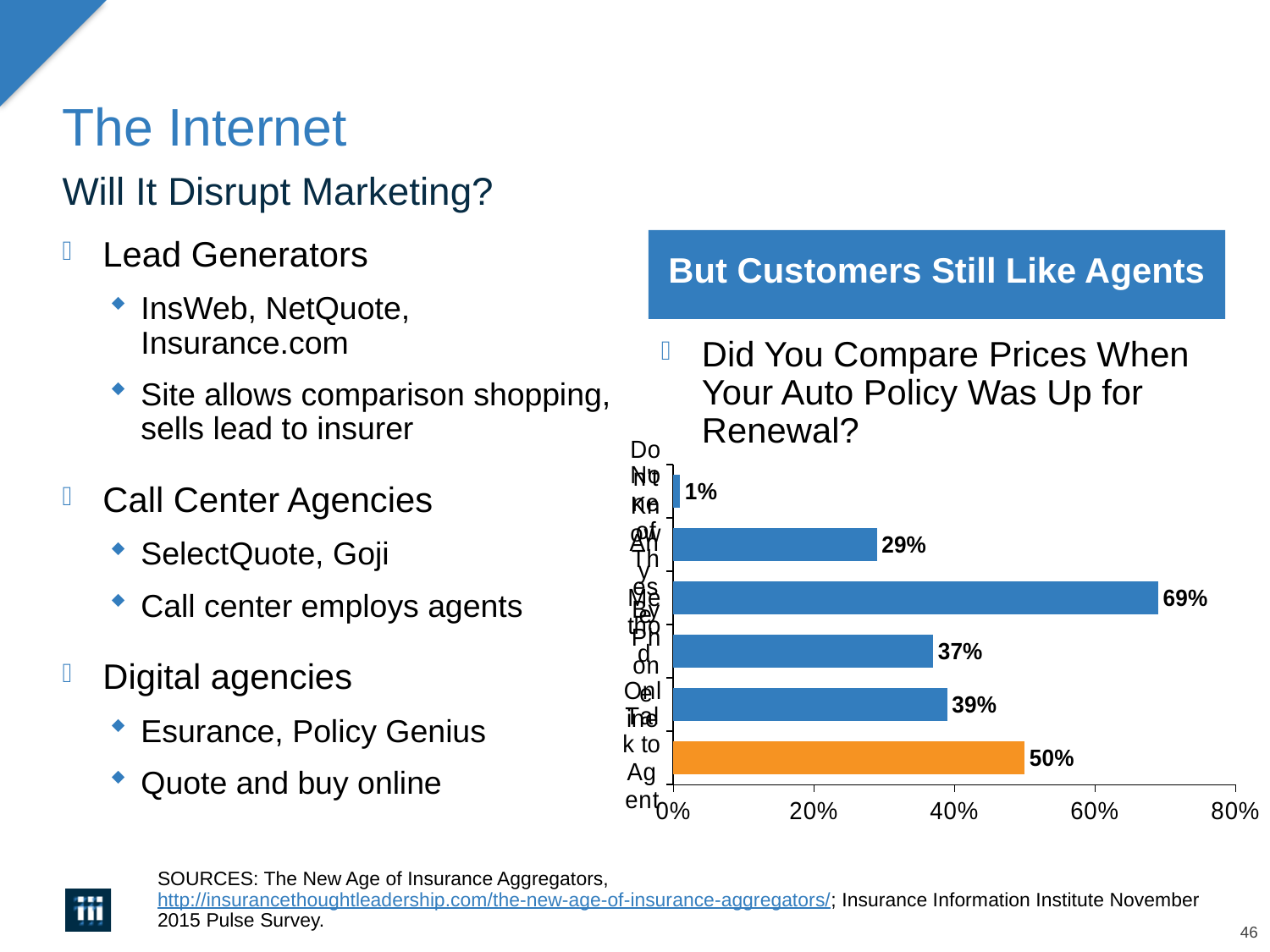
Is the value of the fifth bar from the top greater or less than 40%? less Which is larger: the second bar from the top (29%) or the fourth bar from the top (37%)? the fourth bar (37%) What is the difference between the highest bar value (69%) and the lowest bar value (1%)? 68% What value is labelled on the topmost bar of the chart? 1% What colour is the bottom bar, which differs from the other bars? orange What is the maximum value shown on the horizontal axis? 80% What value is labelled on the bottom (orange) bar of the chart? 50% What kind of chart is shown on the slide? bar chart What is the lowest value shown on the chart? 1% How many bars does the chart contain? 6 What value is labelled on the third bar from the top? 69% What is the highest value shown on the chart? 69%